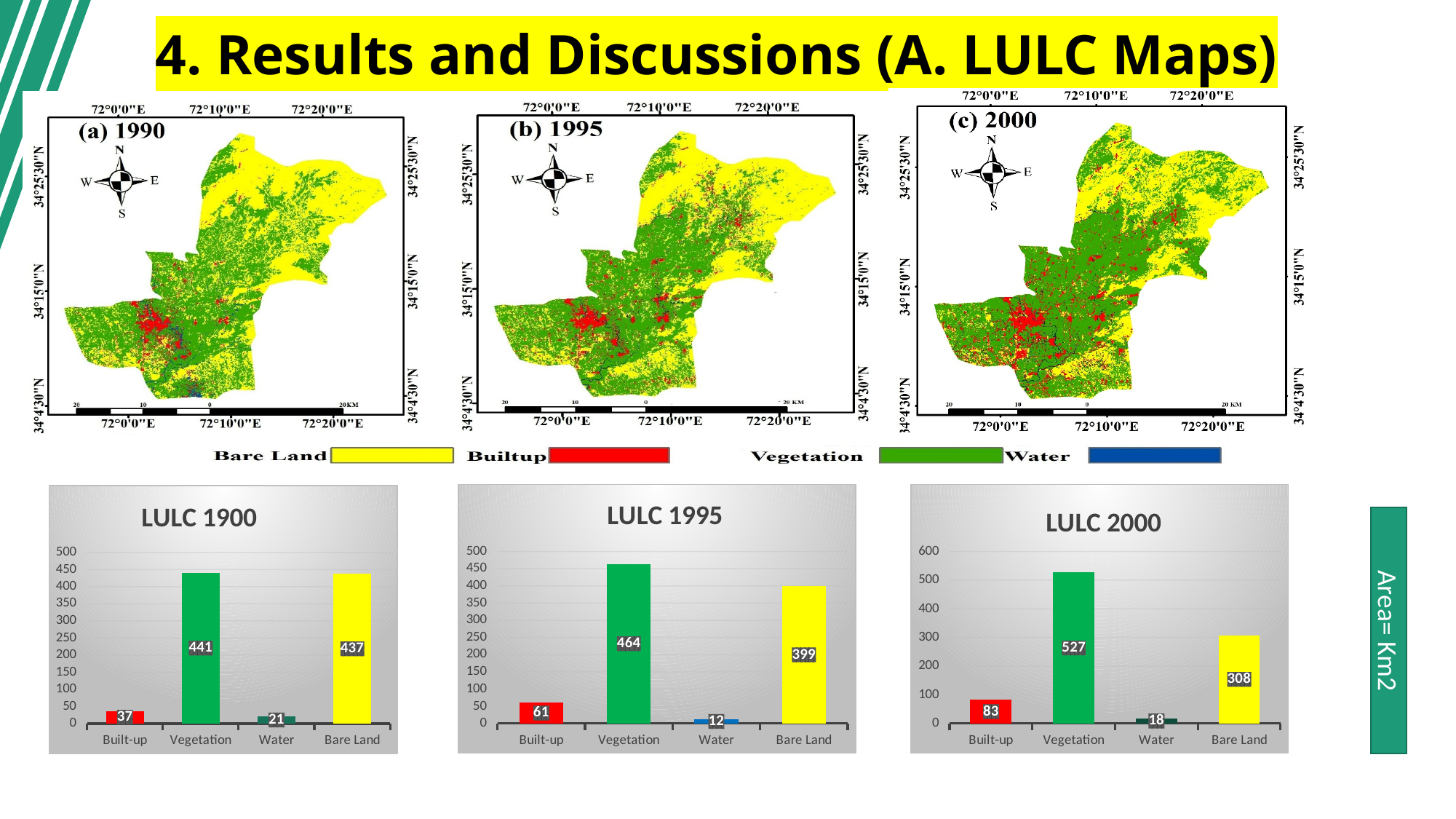
In the LULC 1995 chart, what is the value for Built-up? 61 In the LULC 1900 chart, what is the value for Vegetation? 441 In the LULC 1900 chart, what is the difference between Vegetation and Bare Land? 4 In the LULC 1995 chart, which category has the lowest value? Water In the LULC 2000 chart, what is the value for Water? 18 In the LULC 2000 chart, what is the difference between Vegetation and Bare Land? 219 In the LULC 2000 chart, what is the value for Bare Land? 308 How many categories are shown in the LULC 1995 chart? 4 What type of chart is the LULC 2000 chart? Bar chart In the LULC 1995 chart, which is larger, Built-up or Water? Built-up What unit is indicated for the area values in the charts, according to the label on the right of the slide? Km2 In the LULC 2000 chart, which category has the highest value? Vegetation